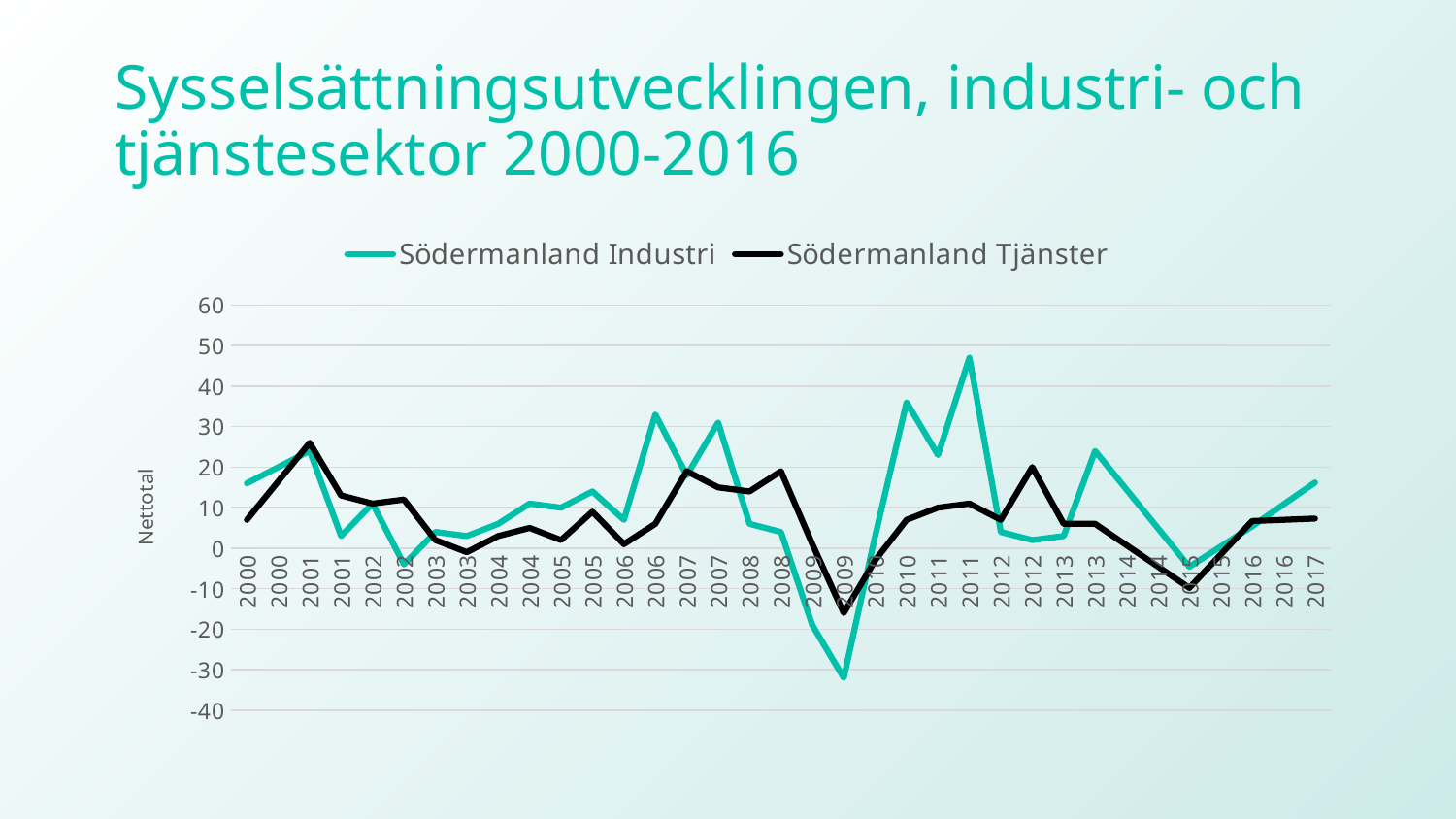
How many series does the legend list? 2 In which year does the Södermanland Tjänster line reach its lowest value? 2009 What kind of chart is shown on the slide? line chart What are the two series named in the legend? Södermanland Industri and Södermanland Tjänster In which year does the Södermanland Industri line reach its lowest value? 2009 Is the lowest value of Södermanland Industri in 2009 greater or less than -20? less Is the lowest value of Södermanland Tjänster in 2009 greater or less than -10? less What is the label on the vertical axis? Nettotal In which year does the Södermanland Industri line reach its highest value? 2011 Is the peak value of Södermanland Industri in 2011 greater or less than 40? greater At the 2011 peak, which series has the larger value, Södermanland Industri or Södermanland Tjänster? Södermanland Industri Does the Södermanland Industri line rise or fall from 2015 to 2017? rise